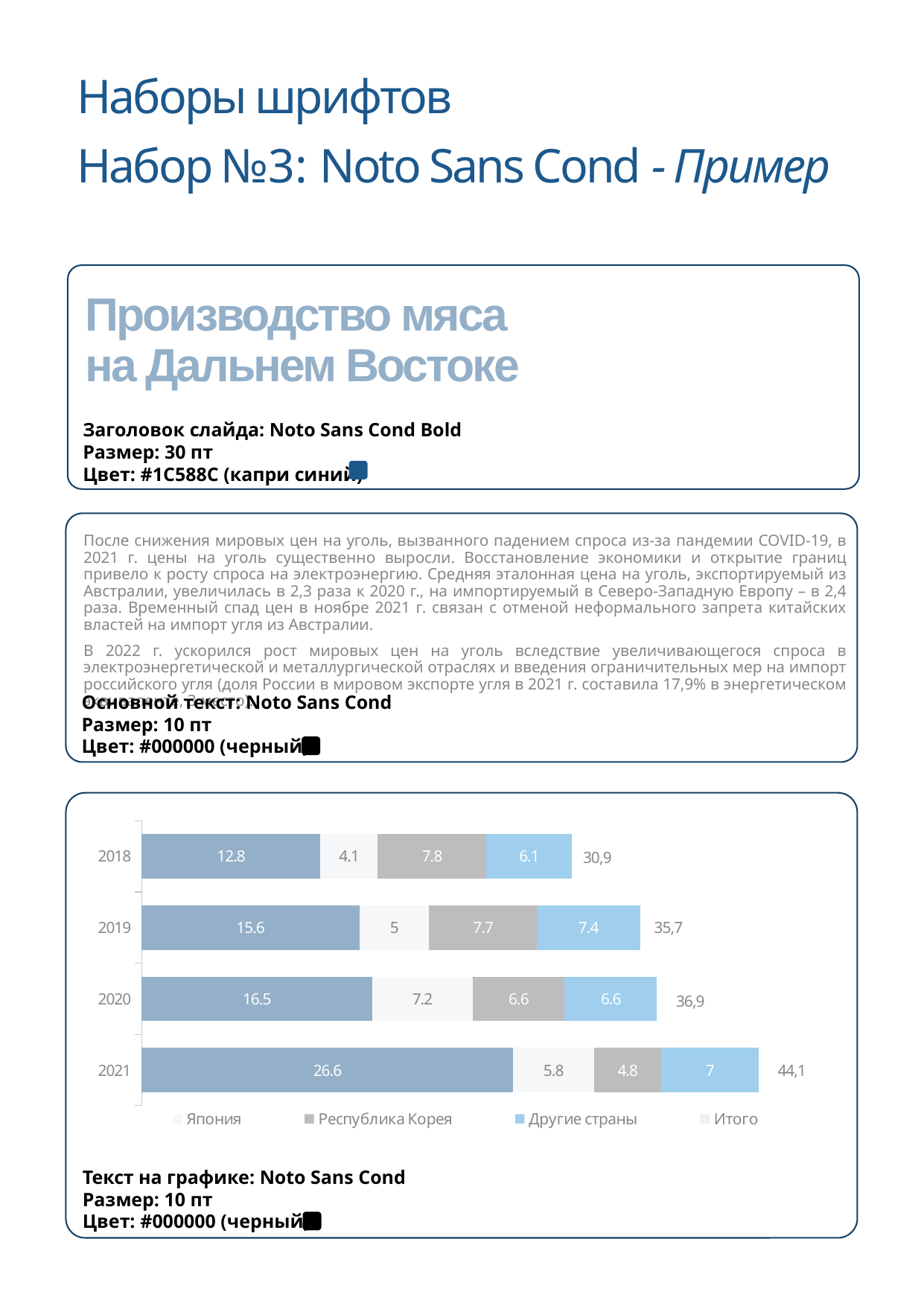
How many entries does the chart legend list? 4 How many years are shown on the chart? 4 What is the value for Другие страны in 2019? 7.4 Which year has the lowest total (Итого)? 2018 What is the value for Япония in 2020? 7.2 Do the totals (Итого) rise or fall from 2018 to 2021? Rise What is the total (Итого) shown for 2021? 44,1 What kind of chart is shown on the slide? Stacked bar chart Which year has the highest total (Итого)? 2021 What is the difference between the Япония value in 2020 and in 2018? 3.1 Which is larger: the Республика Корея value in 2019 or in 2021? 2019 What is the value for Республика Корея in 2018? 7.8